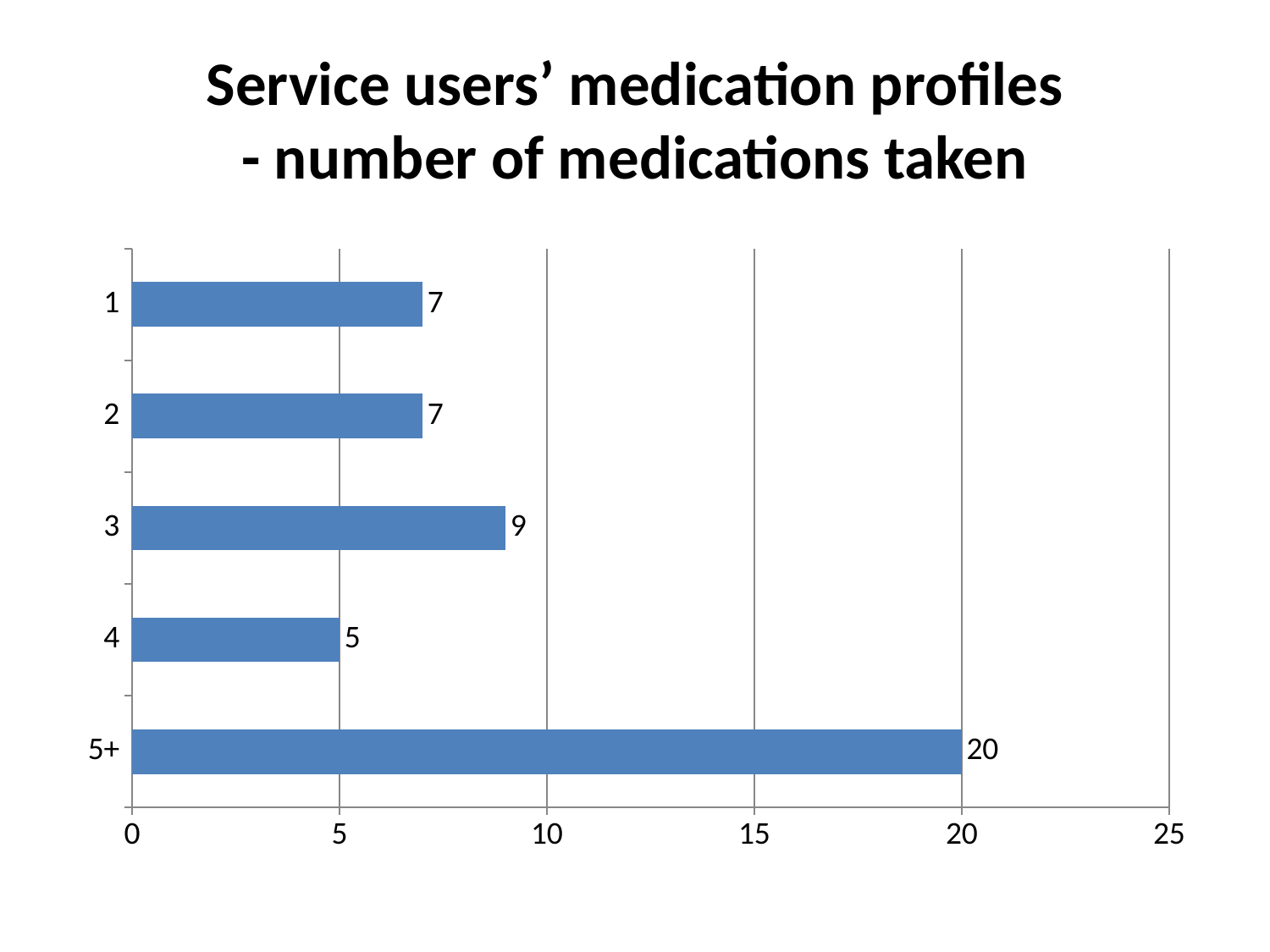
What is the difference between the values for "5+" and "3"? 11 What kind of chart is shown on the slide? bar chart What is the title of the chart? Service users' medication profiles - number of medications taken Which is larger, the value for "3" or the value for "2"? 3 Which category has the highest value? 5+ What is the difference between the values for "3" and "4"? 4 How many categories are shown in the chart? 5 What is the value for the category "5+"? 20 Is the value for "5+" greater or less than 15? greater Which category has the lowest value? 4 What is the value for the category "3"? 9 What is the value for the category "4"? 5